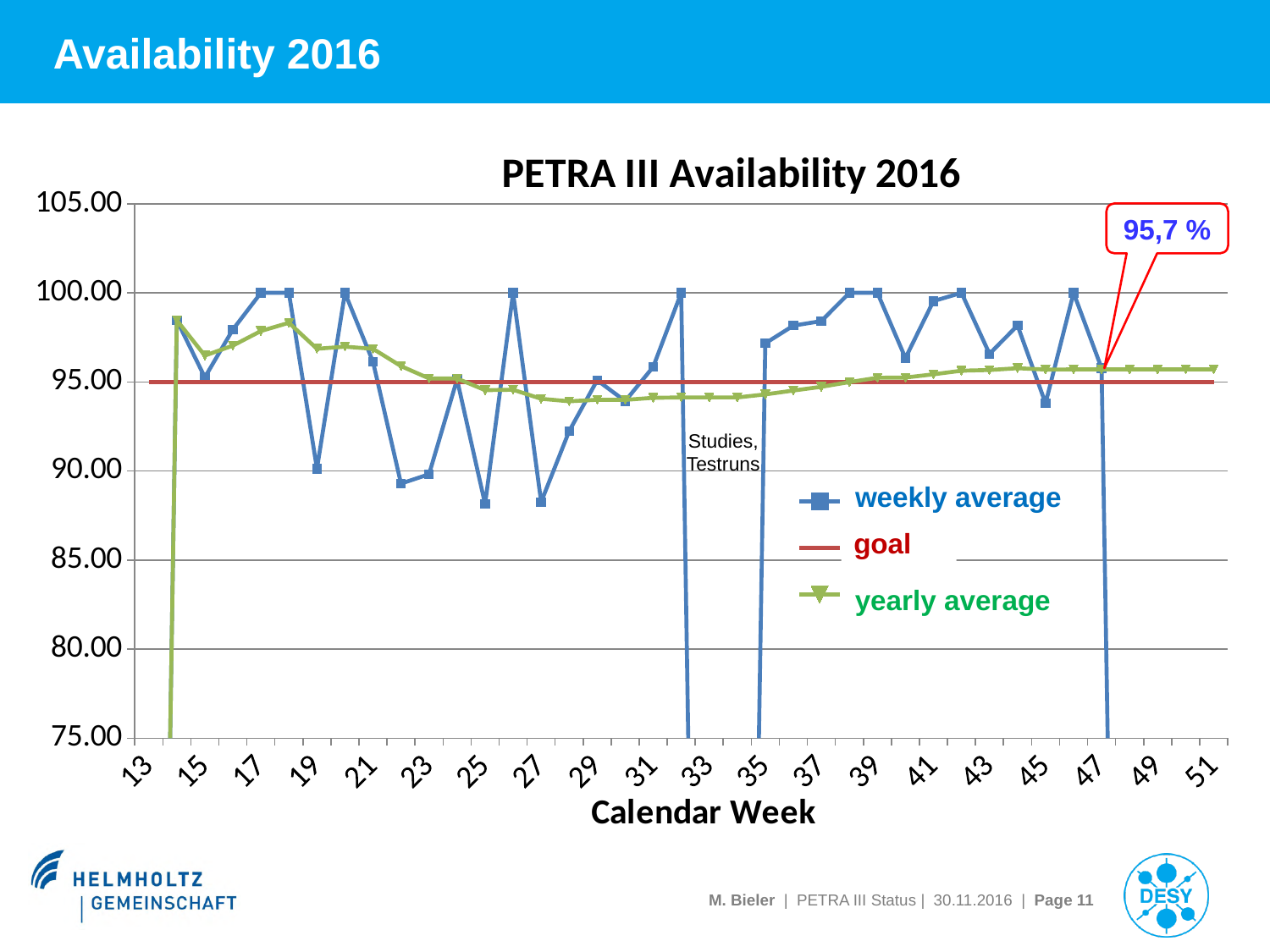
How many series does the legend list? 3 Which is larger, the weekly average at calendar week 17 or at calendar week 19? calendar week 17 What kind of chart is shown on the slide? line chart Is the weekly average at calendar week 37 greater or less than 95.00? greater Is the weekly average at calendar week 25 greater or less than 90.00? less What yearly average value is called out in the annotation at calendar week 47? 95,7 % What value does the goal line sit at? 95.00 Is the weekly average at calendar week 19 greater or less than 95.00? less What is the title of the chart? PETRA III Availability 2016 What is the label of the x axis? Calendar Week What is the weekly average at calendar week 17? 100.00 Does the yearly average rise or fall between calendar week 30 and calendar week 47? rise